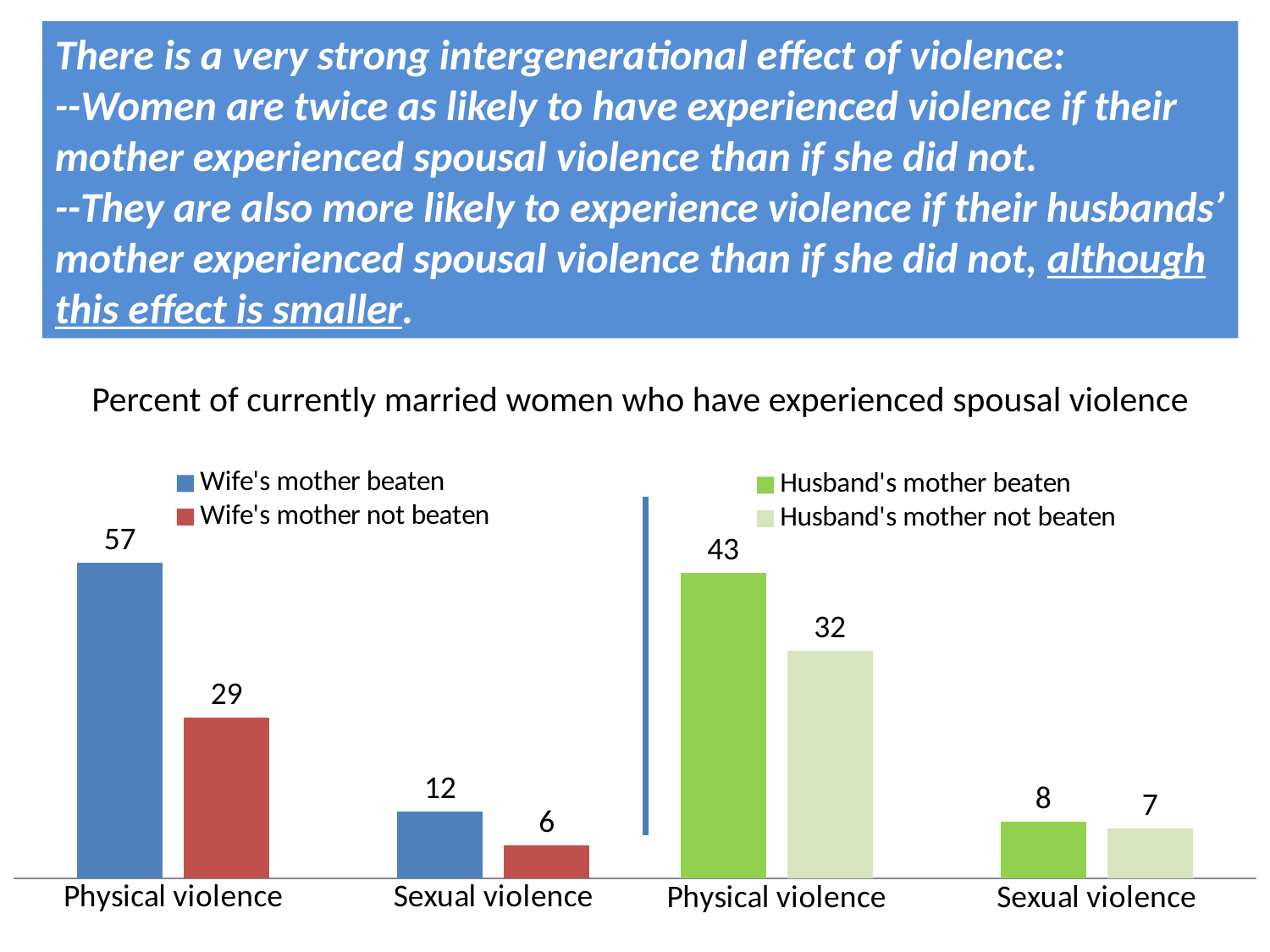
What is the title of the chart? Percent of currently married women who have experienced spousal violence What is the value for physical violence when the husband's mother was beaten? 43 What is the percent of currently married women who have experienced physical violence when the wife's mother was beaten? 57 Which bar has the lowest value on the chart? Sexual violence, wife's mother not beaten (6) What is the difference between physical violence when the husband's mother was beaten and when she was not beaten? 11 What is the value for sexual violence when the husband's mother was not beaten? 7 What is the value for sexual violence when the wife's mother was not beaten? 6 Which is larger: physical violence when the wife's mother was beaten or physical violence when the husband's mother was beaten? Wife's mother beaten How many series do the legends list in total? 4 What is the difference between physical violence when the wife's mother was beaten and when she was not beaten? 28 What kind of chart is shown on the slide? Bar chart Which bar has the highest value on the chart? Physical violence, wife's mother beaten (57)